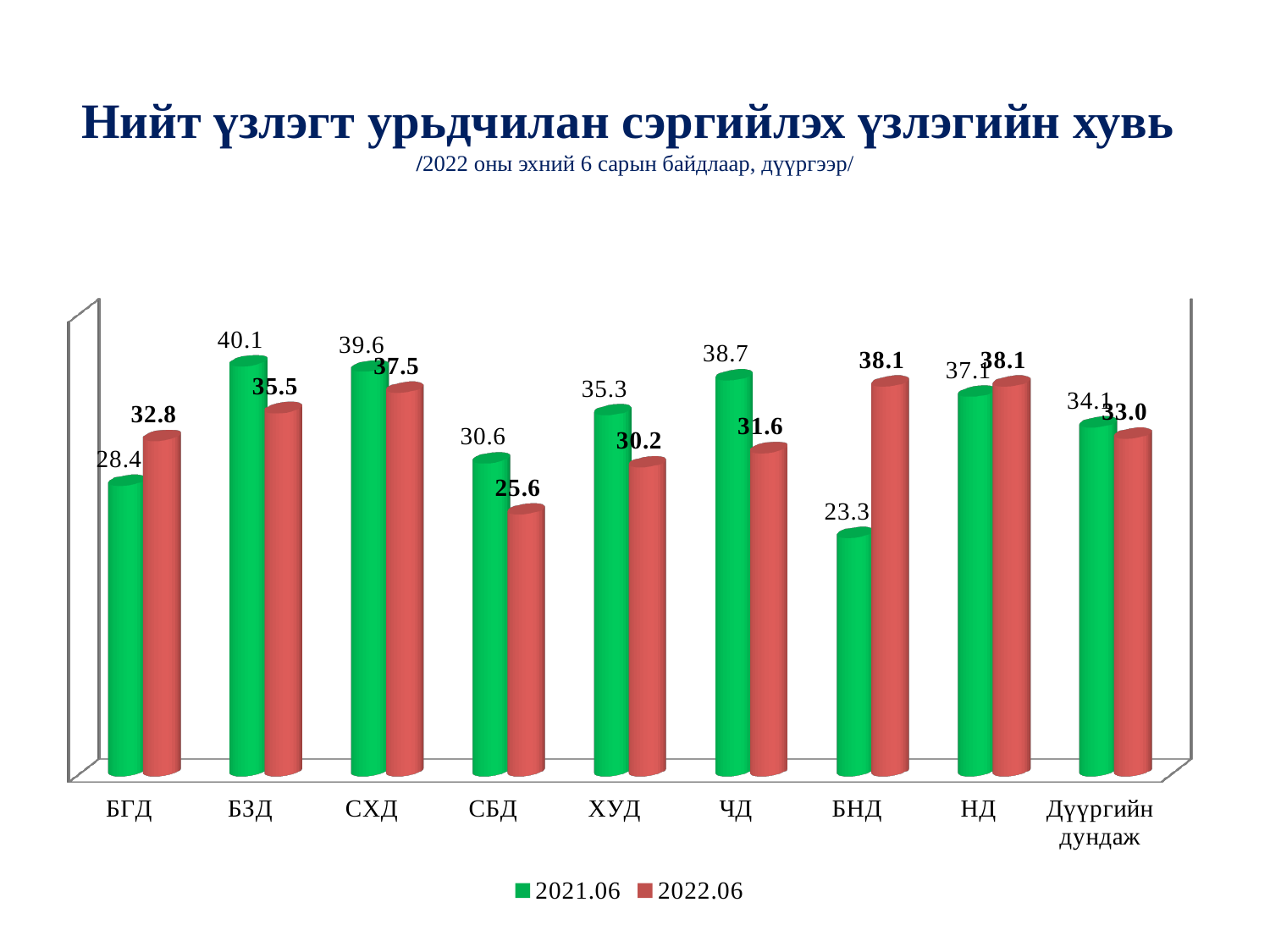
Which category has the lowest 2021.06 value? БНД What is the 2021.06 value for БНД? 23.3 How many series does the legend list? 2 Which category has the highest 2021.06 value? БЗД Which is larger for ЧД: the 2021.06 value or the 2022.06 value? 2021.06 Which category has the lowest 2022.06 value? СБД What is the 2022.06 value for СБД? 25.6 What is the 2021.06 value for БЗД? 40.1 What kind of chart is shown on the slide? Bar chart How many categories are shown on the x axis? 9 What is the difference between the 2022.06 and 2021.06 values for БНД? 14.8 What is the 2022.06 value for Дүүргийн дундаж? 33.0